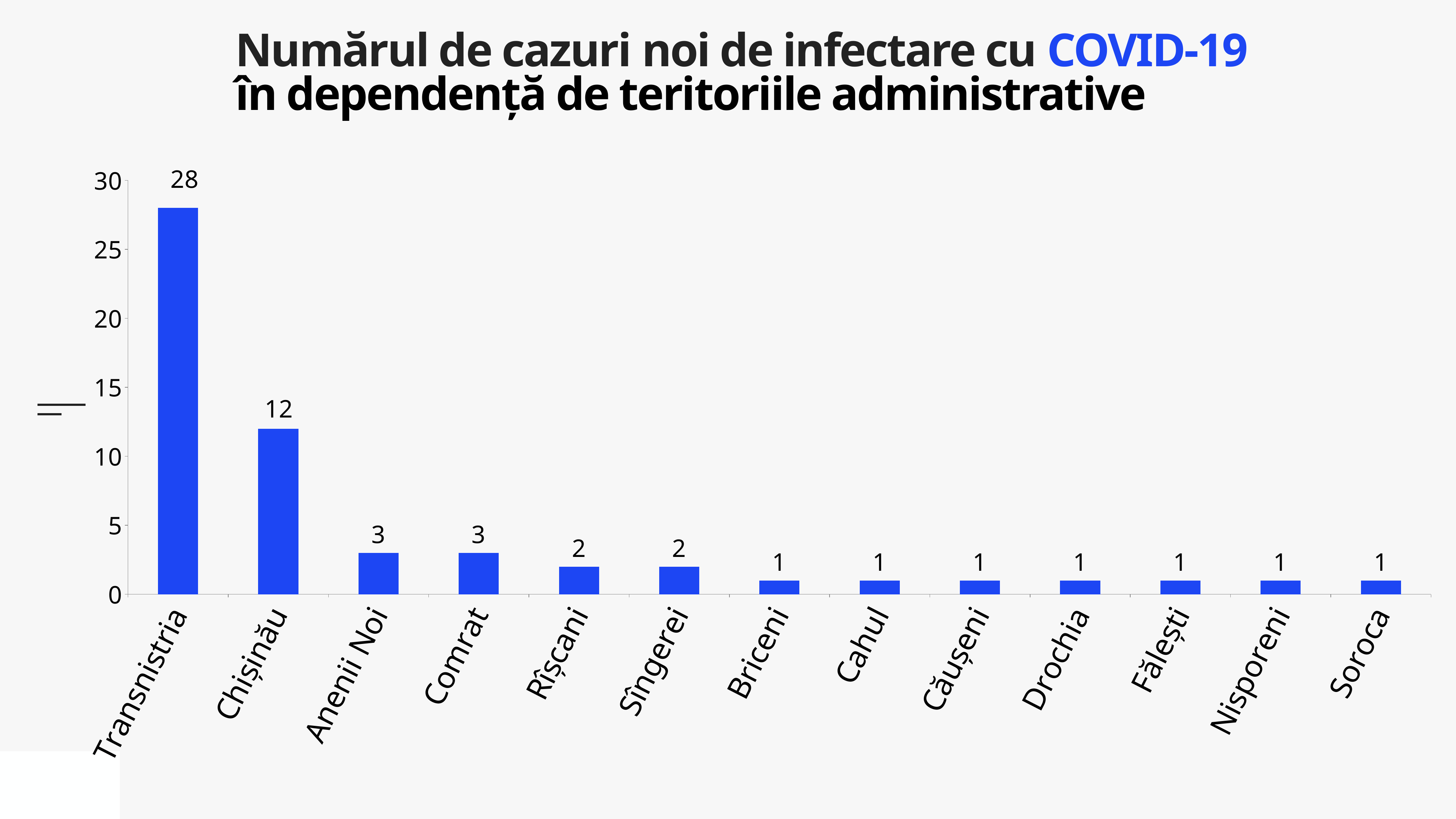
What is the value for Rîșcani? 2 What is the value for Transnistria? 28 Which category has the highest value? Transnistria What is the value for Anenii Noi? 3 What kind of chart is shown on the slide? bar chart What is the value for Chișinău? 12 What is the difference between the values for Transnistria and Chișinău? 16 What is the value for Soroca? 1 How many categories are shown on the x axis? 13 Which is larger, the value for Comrat or the value for Sîngerei? Comrat Is the value for Chișinău greater or less than 10? greater Do the values rise or fall from left to right along the x axis? fall